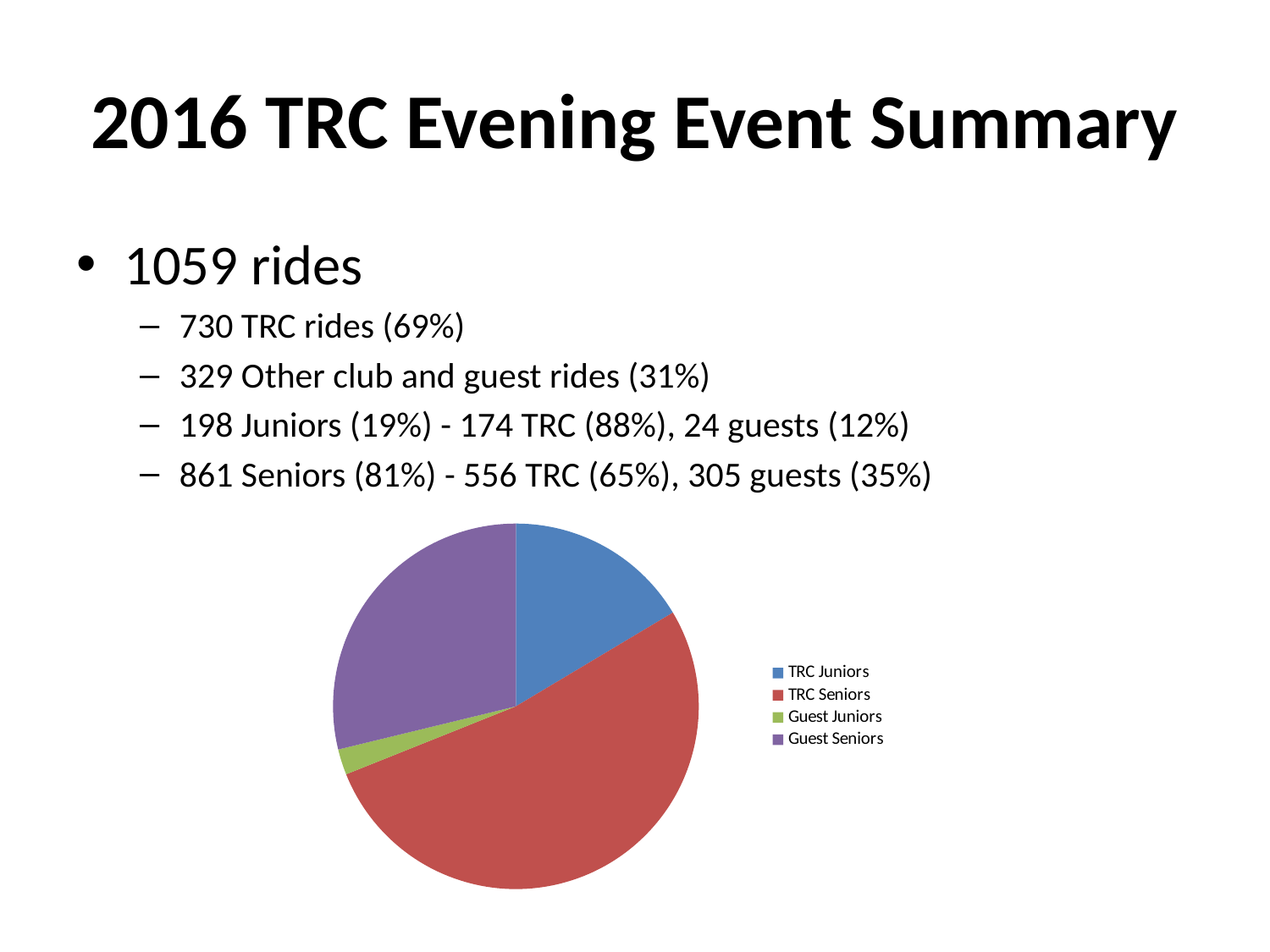
What colour is the TRC Seniors slice in the pie chart? red Which category has the largest slice of the pie chart? TRC Seniors Which slice is larger in the pie chart, TRC Juniors or Guest Juniors? TRC Juniors Which slice is larger in the pie chart, TRC Seniors or Guest Seniors? TRC Seniors How many slices does the pie chart have? 4 Which legend entry is shown in purple in the pie chart? Guest Seniors What kind of chart is shown on the slide? pie chart Does the TRC Seniors slice take up more or less than half of the pie chart? more Which slice is larger in the pie chart, Guest Seniors or TRC Juniors? Guest Seniors How many entries does the pie chart's legend list? 4 Which category has the smallest slice of the pie chart? Guest Juniors